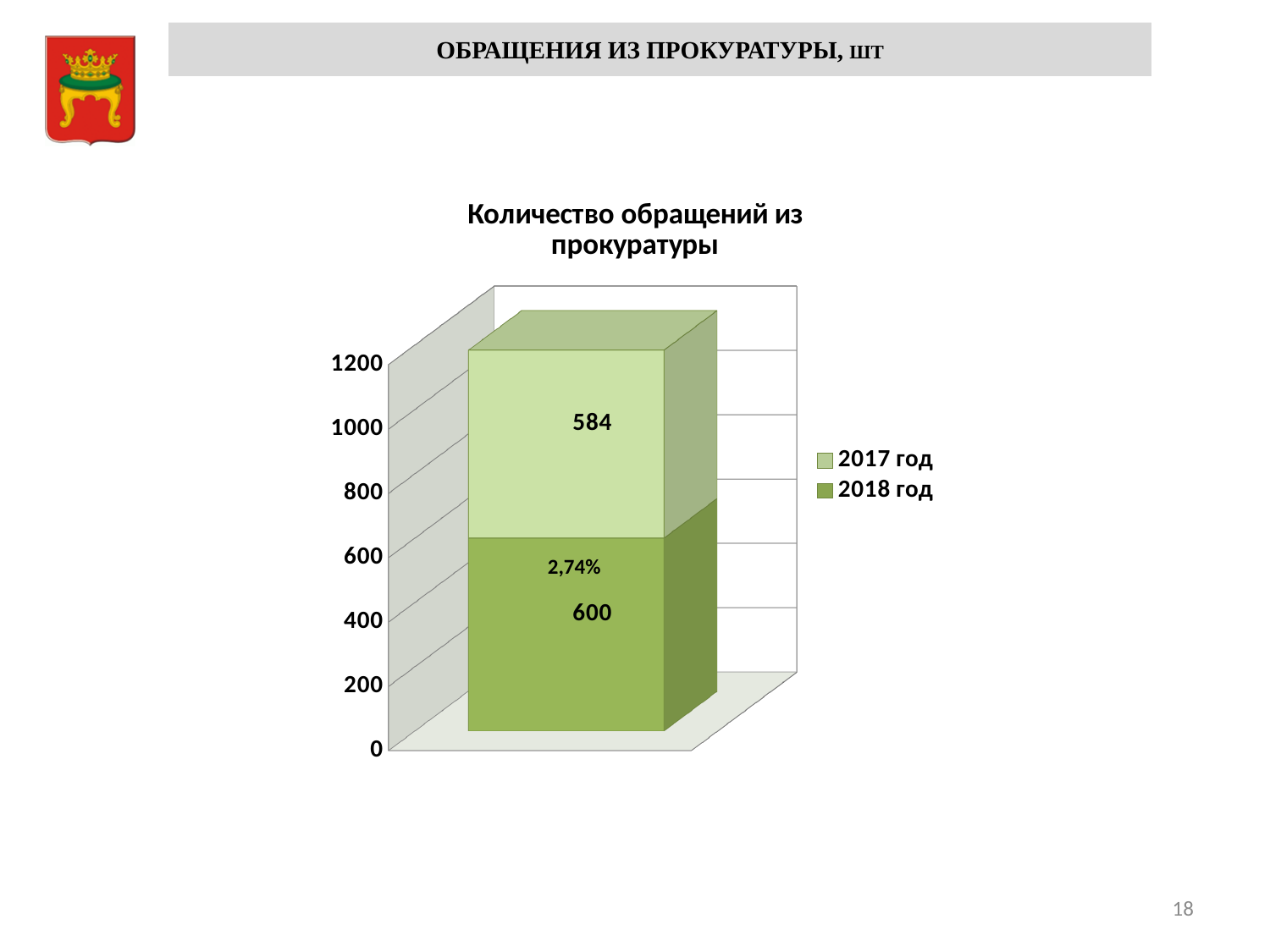
What percentage label is printed on the 2018 год segment of the bar? 2,74% Is the total height of the stacked bar greater or less than 1000? greater What is the value for 2018 год in the chart? 600 Which series has the smaller value? 2017 год How many series does the legend list? 2 What is the difference between the 2018 год value and the 2017 год value? 16 What kind of chart is shown on the slide? Stacked bar chart What is the value for 2017 год in the chart? 584 Which series has the larger value, 2017 год or 2018 год? 2018 год What is the total of the stacked bar (2017 год plus 2018 год)? 1184 How many bars are plotted in the chart? 1 What is the title of the chart? Количество обращений из прокуратуры